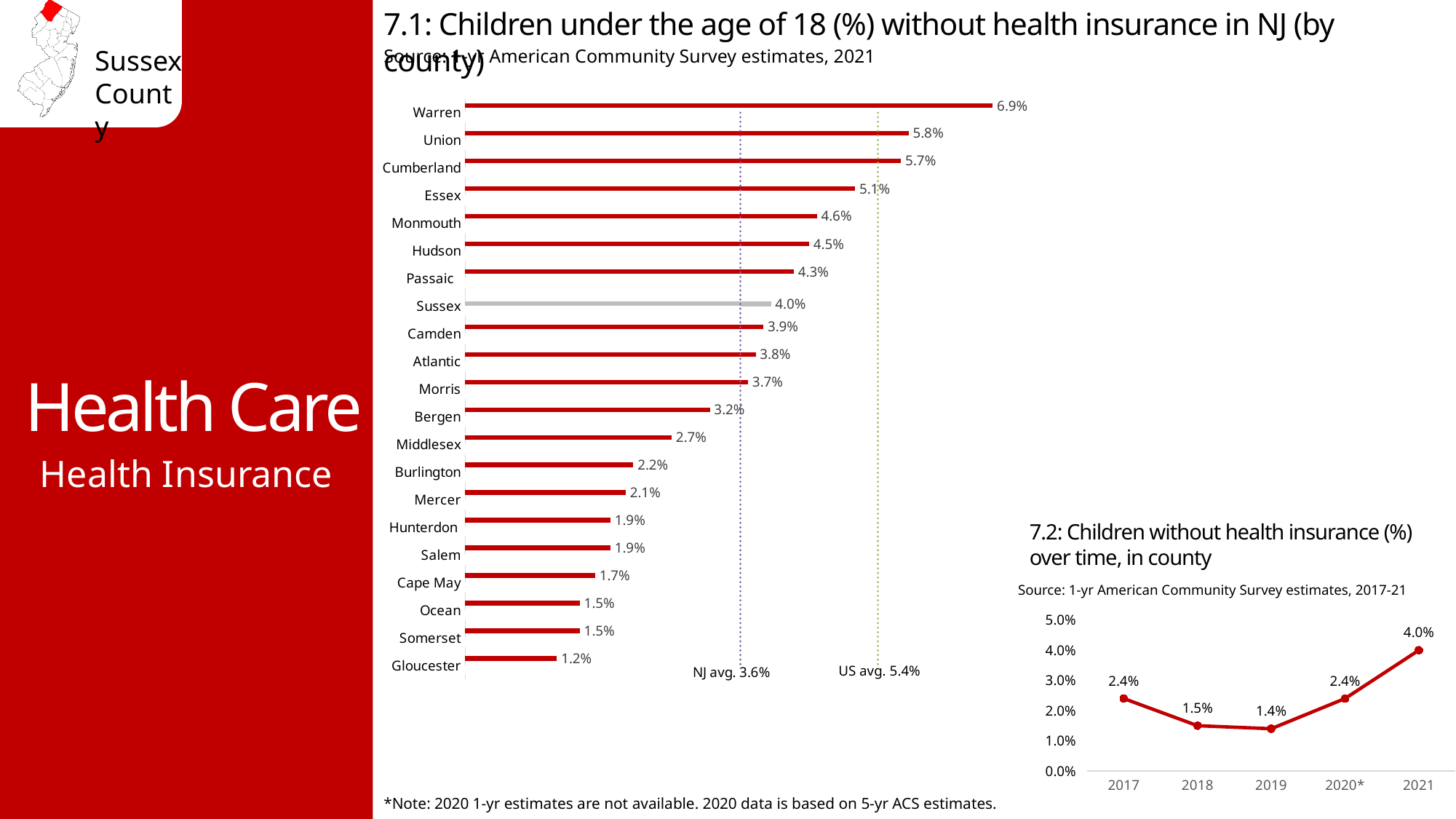
In chart 7.1, which county has a higher value, Hudson or Passaic? Hudson In chart 7.2, which year has the highest value? 2021 What kind of chart is chart 7.2? Line chart What kind of chart is chart 7.1? Bar chart In chart 7.1 (children under 18 without health insurance by county), what is the value for Sussex? 4.0% In chart 7.2, what is the difference between the 2021 and 2017 values? 1.6% In chart 7.1, which county has the highest percentage of children without health insurance? Warren In chart 7.1, how many counties are shown? 21 In chart 7.2 (children without health insurance over time), what is the value for 2019? 1.4% In chart 7.1, what is the NJ average shown by the dotted reference line? 3.6% In chart 7.1, which county has the lowest percentage of children without health insurance? Gloucester In chart 7.1, what is the difference between the values for Warren and Gloucester? 5.7%